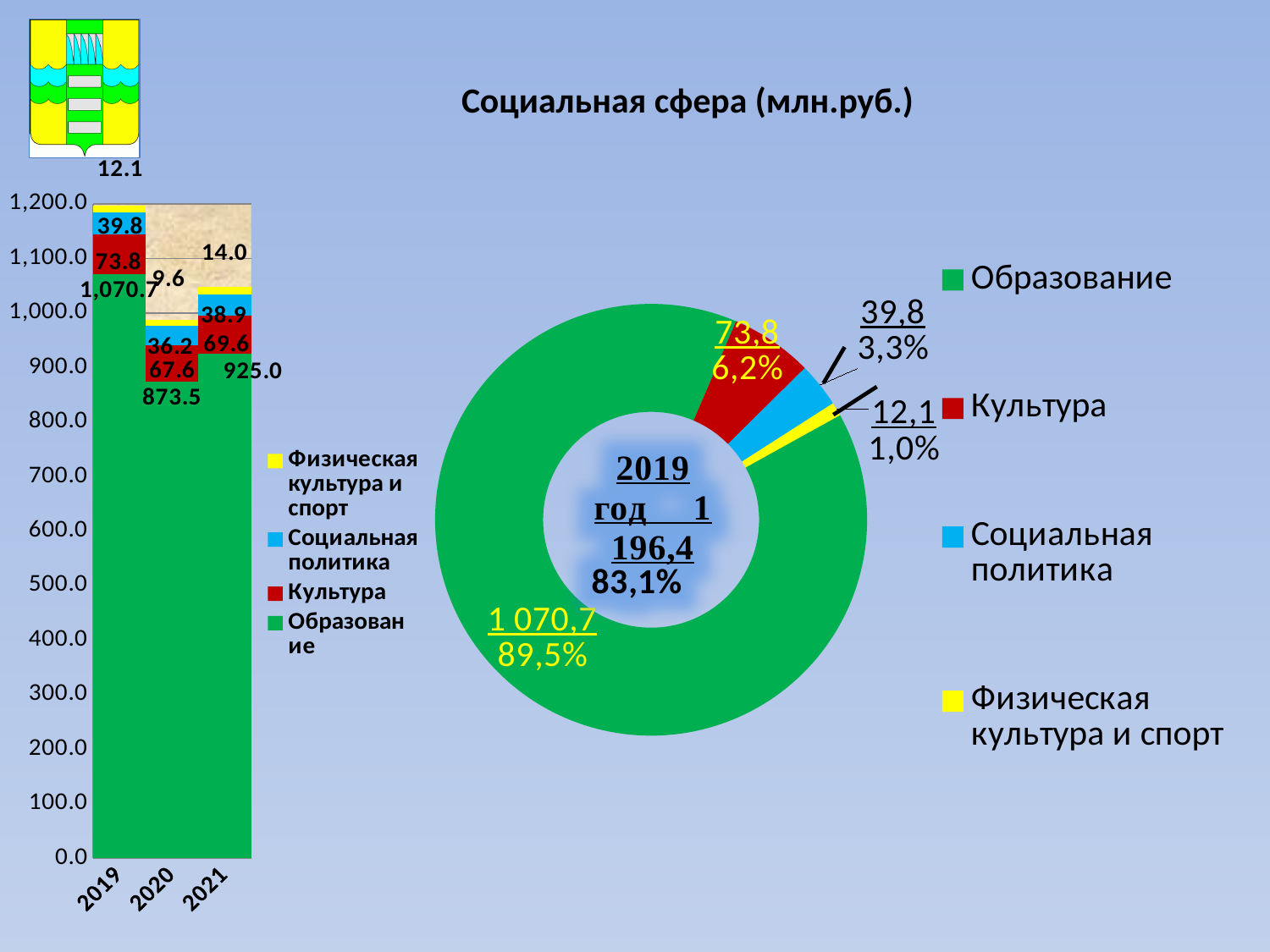
In the stacked bar chart on the left, what is the value for Образование in 2019? 1,070.7 In the stacked bar chart on the left, what is the value for Социальная политика in 2021? 38.9 In the stacked bar chart on the left, is the Физическая культура и спорт value larger in 2021 or in 2020? 2021 How many series does the legend of the chart titled 'Социальная сфера (млн.руб.)' list? 4 In the stacked bar chart on the left, what is the total of the stacked bar for 2021? 1,047.5 In the chart titled 'Социальная сфера (млн.руб.)', what is the value for Социальная политика? 39,8 What kind of chart is the chart titled 'Социальная сфера (млн.руб.)'? Doughnut chart In the stacked bar chart on the left, what is the difference between the Образование values for 2019 and 2020? 197.2 In the stacked bar chart on the left, which year has the lowest value for Образование? 2020 In the stacked bar chart on the left, what is the value for Культура in 2020? 67.6 How many years are shown on the x axis of the stacked bar chart on the left? 3 In the chart titled 'Социальная сфера (млн.руб.)', what share does Образование have? 89,5%